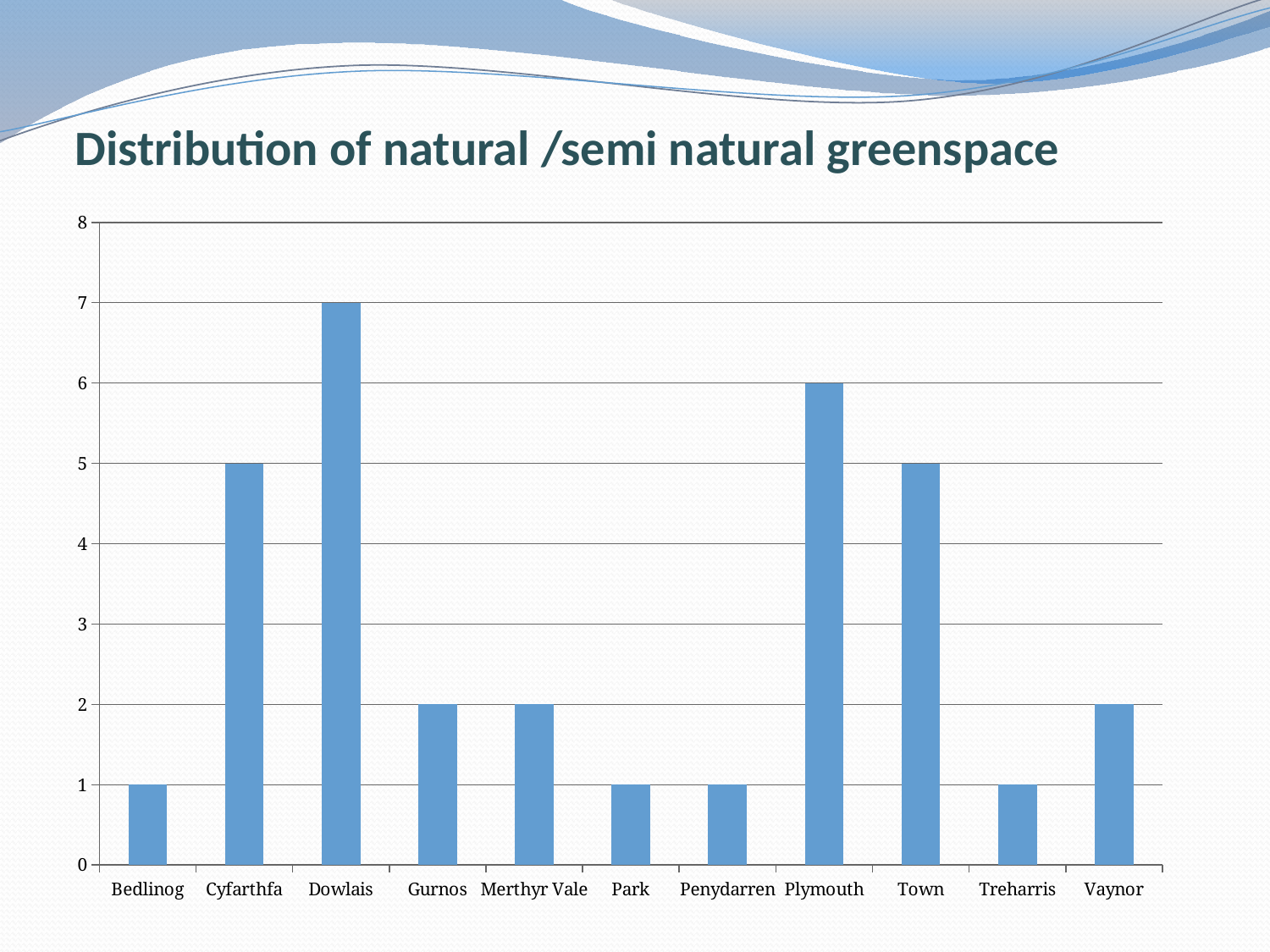
What is the difference between the values for Dowlais and Plymouth? 1 Which is larger, the value for Gurnos or the value for Cyfarthfa? Cyfarthfa What is the title of the slide containing the chart? Distribution of natural /semi natural greenspace How many categories are shown on the x axis? 11 What is the value for Plymouth? 6 Which category has the highest value? Dowlais What is the value for Cyfarthfa? 5 Is the value for Plymouth greater or less than 4? greater What kind of chart is shown on the slide? Bar chart What is the difference between the values for Town and Treharris? 4 What is the value for Vaynor? 2 What is the value for Dowlais? 7